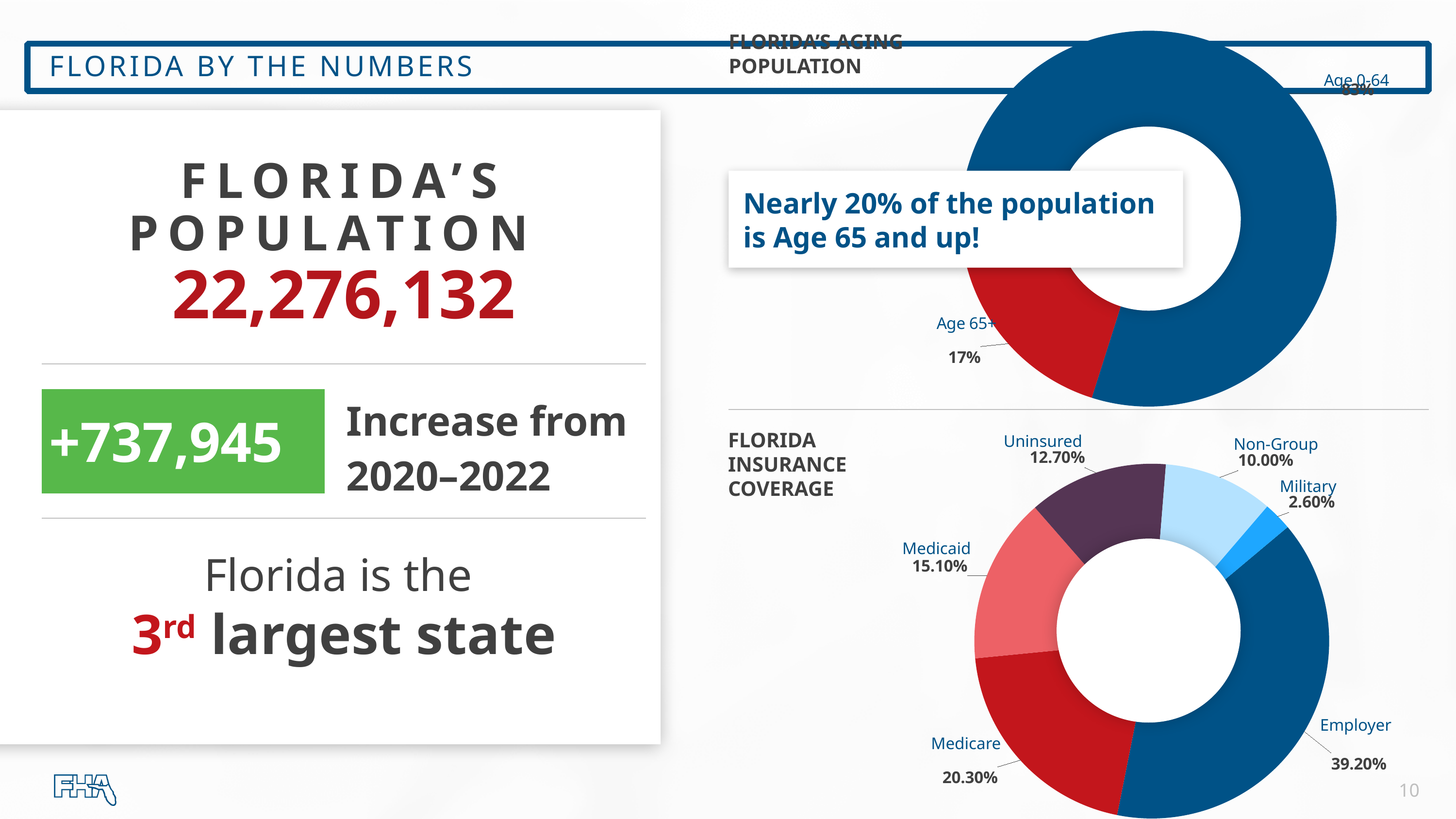
In the Florida Insurance Coverage chart, which coverage category has the smallest share? Military In the Florida Insurance Coverage chart, what percentage is shown for Military coverage? 2.60% In the Florida's Aging Population chart, what colour is the Age 65+ segment? Red How many coverage categories are shown in the Florida Insurance Coverage chart? 6 In the Florida Insurance Coverage chart, what percentage is shown for Employer coverage? 39.20% What kind of chart is the Florida Insurance Coverage chart? Donut (pie) chart In the Florida Insurance Coverage chart, which is larger, Medicaid or Uninsured? Medicaid In the Florida Insurance Coverage chart, which coverage category has the largest share? Employer In the Florida's Aging Population chart, which segment is larger, Age 0-64 or Age 65+? Age 0-64 In the Florida's Aging Population chart, what percentage is shown for Age 65+? 17% In the Florida Insurance Coverage chart, what percentage is shown for Medicare? 20.30% In the Florida Insurance Coverage chart, what is the difference between the Employer and Medicare percentages? 18.90%